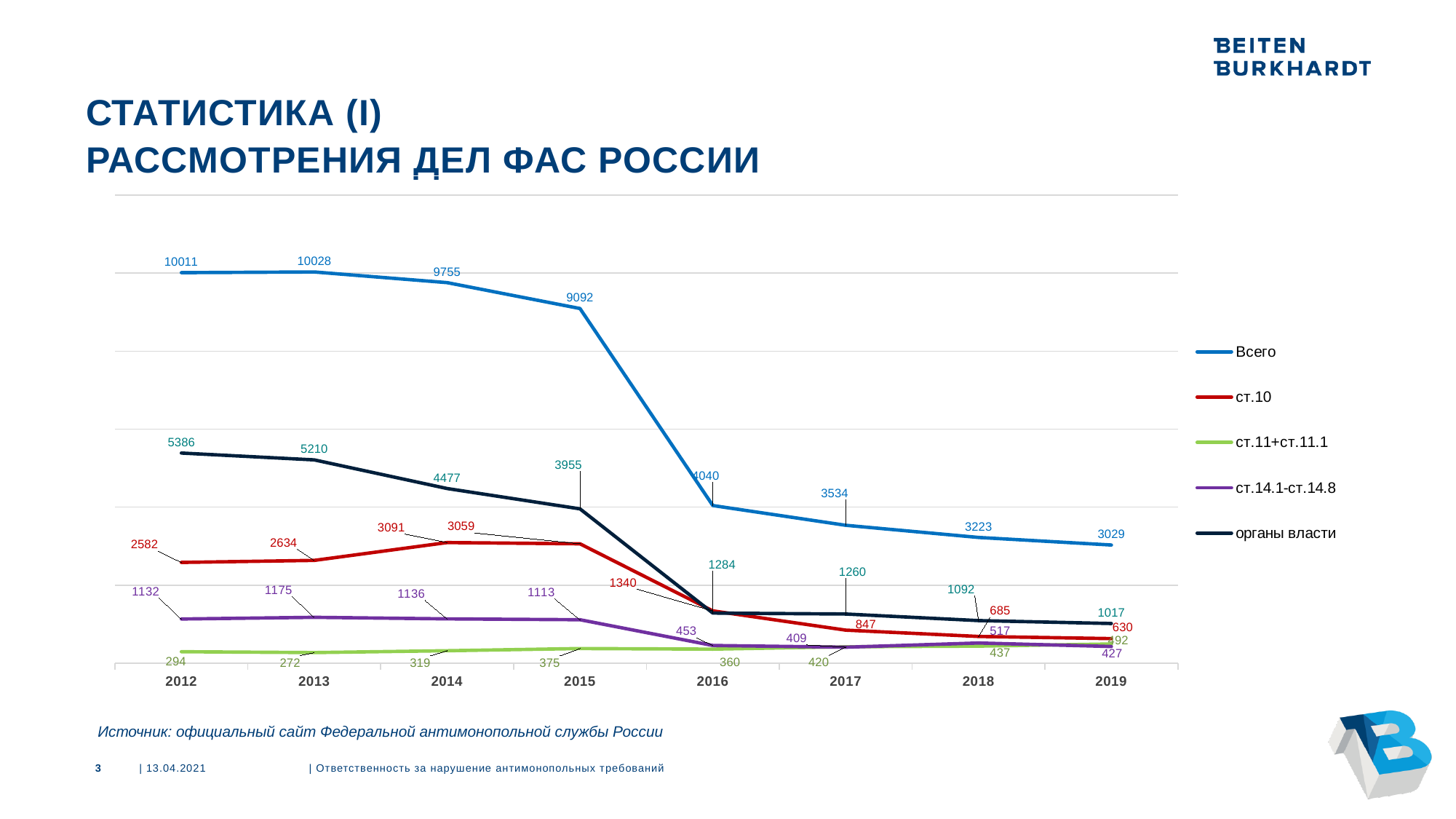
What is the value of the Всего series in 2013? 10028 What is the value of the ст.14.1-ст.14.8 series in 2018? 517 Does the органы власти series rise or fall from 2012 to 2019? fall What is the value of the органы власти series in 2016? 1284 What is the difference between the Всего values in 2015 and 2016? 5052 Which is larger in 2017: the ст.10 value or the ст.14.1-ст.14.8 value? ст.10 How many series does the legend list? 5 How many years are shown on the x axis? 8 What is the value of the ст.10 series in 2014? 3091 What type of chart is shown on the slide? line chart In which year is the Всего series at its highest? 2013 In which year is the ст.11+ст.11.1 series at its lowest? 2013